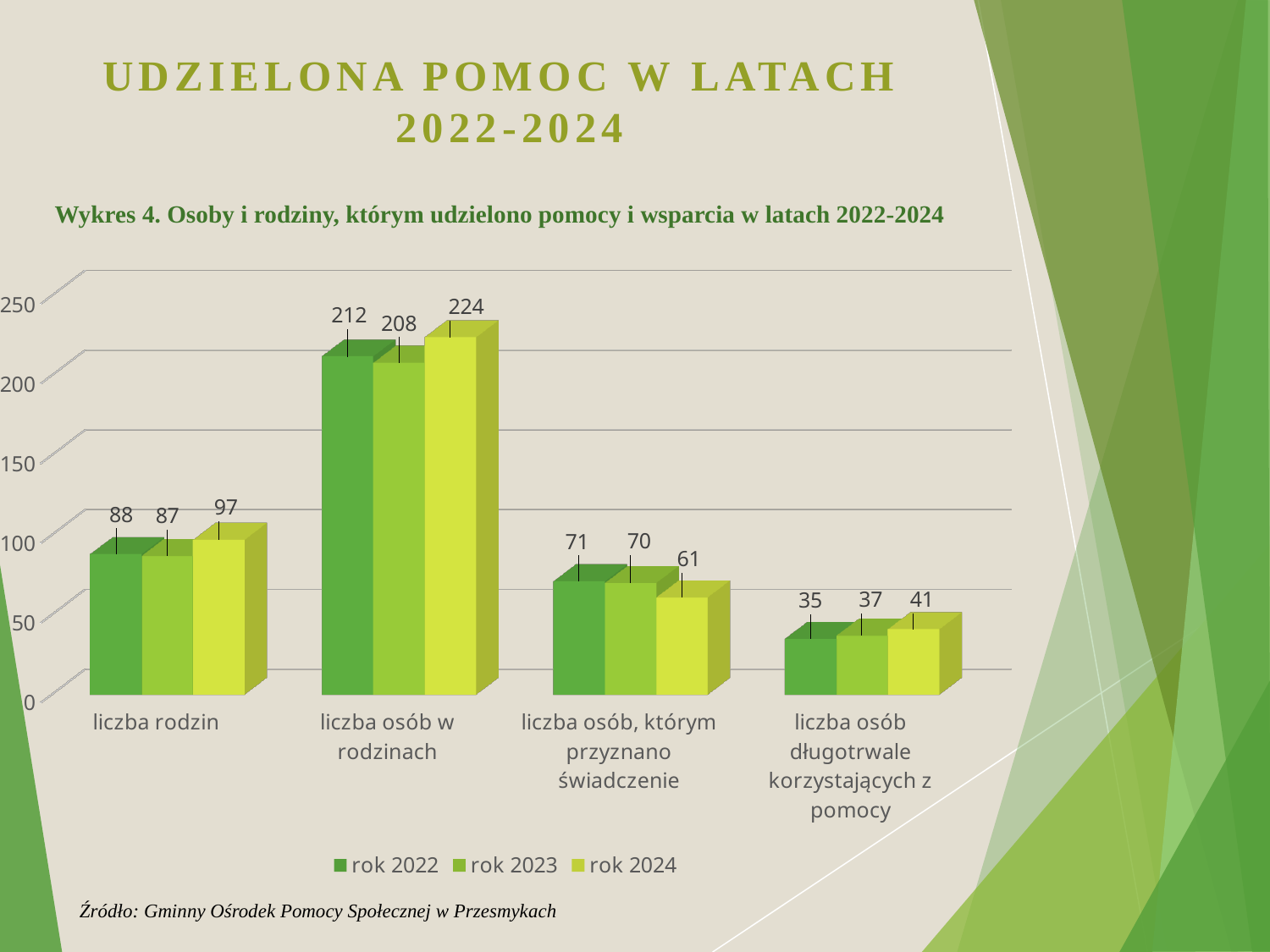
What is the value for 'liczba osób długotrwale korzystających z pomocy' in the 'rok 2022' series? 35 Which category has the highest value in the 'rok 2024' series? liczba osób w rodzinach What kind of chart is shown on the slide? bar chart What is the source cited below the chart? Gminny Ośrodek Pomocy Społecznej w Przesmykach What is the difference between the 'rok 2024' and 'rok 2022' values for 'liczba osób w rodzinach'? 12 How many series does the legend list? 3 Which is larger for 'liczba osób, którym przyznano świadczenie': the 'rok 2022' value or the 'rok 2024' value? rok 2022 Is the 'rok 2023' value for 'liczba osób, którym przyznano świadczenie' greater or less than 100? less What is the value for 'liczba rodzin' in the 'rok 2024' series? 97 Which category has the lowest value in the 'rok 2022' series? liczba osób długotrwale korzystających z pomocy How many categories are shown on the x axis? 4 What is the value for 'liczba osób w rodzinach' in the 'rok 2023' series? 208